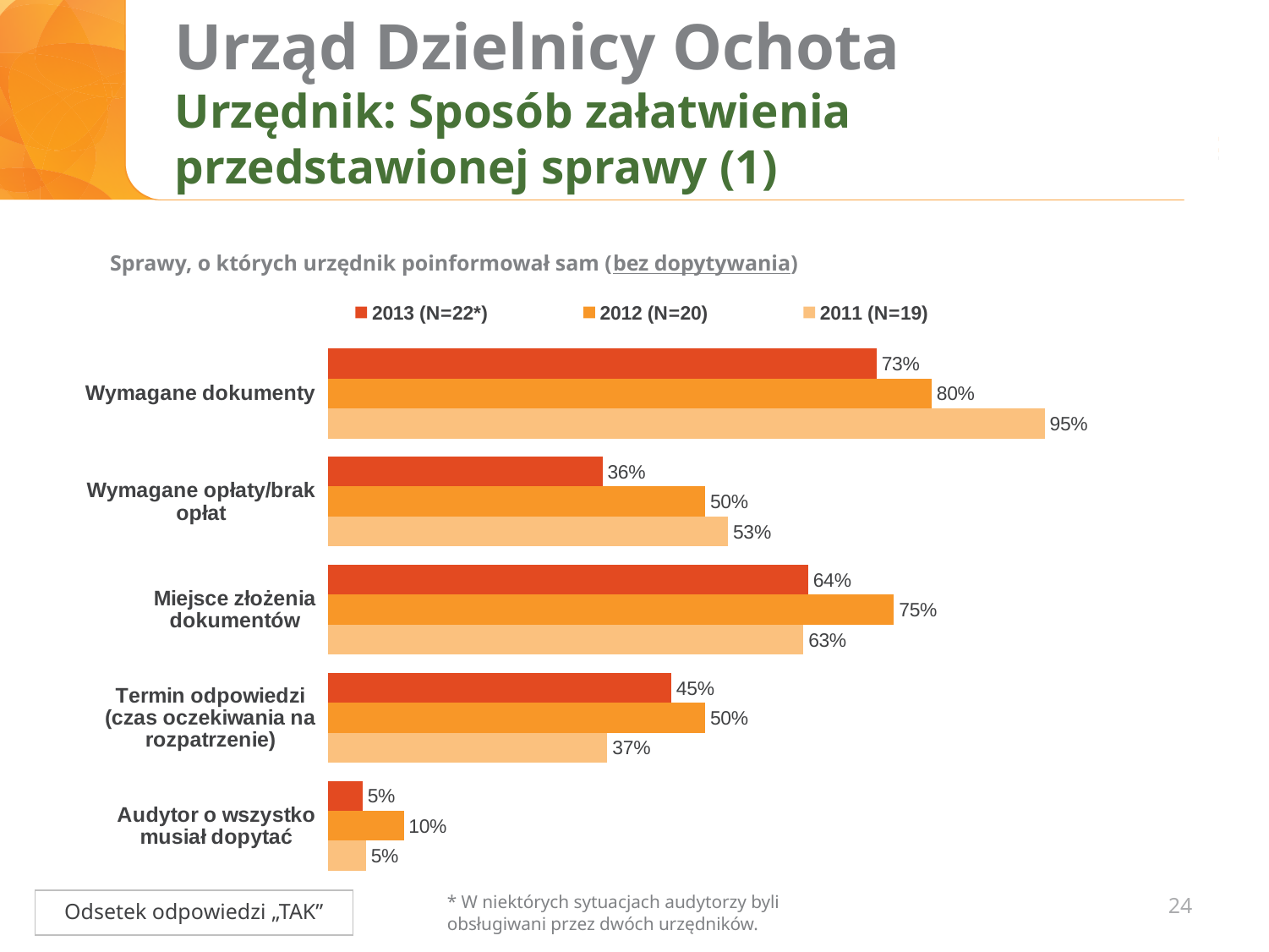
What is the value for "Miejsce złożenia dokumentów" in the 2012 (N=20) series? 75% How many categories are shown in the chart? 5 What is the subtitle shown above the chart legend? Sprawy, o których urzędnik poinformował sam (bez dopytywania) For "Miejsce złożenia dokumentów", which series has the larger value: 2013 (N=22*) or 2011 (N=19)? 2013 (N=22*) What is the difference between the 2011 (N=19) and 2013 (N=22*) values for "Wymagane dokumenty"? 22% What is the difference between the 2012 (N=20) and 2011 (N=19) values for "Termin odpowiedzi (czas oczekiwania na rozpatrzenie)"? 13% What is the value for "Termin odpowiedzi (czas oczekiwania na rozpatrzenie)" in the 2013 (N=22*) series? 45% What is the value for "Wymagane dokumenty" in the 2011 (N=19) series? 95% How many series does the legend list? 3 What type of chart is shown on the slide? Bar chart Which category has the highest value in the 2013 (N=22*) series? Wymagane dokumenty Which category has the lowest value in the 2012 (N=20) series? Audytor o wszystko musiał dopytać